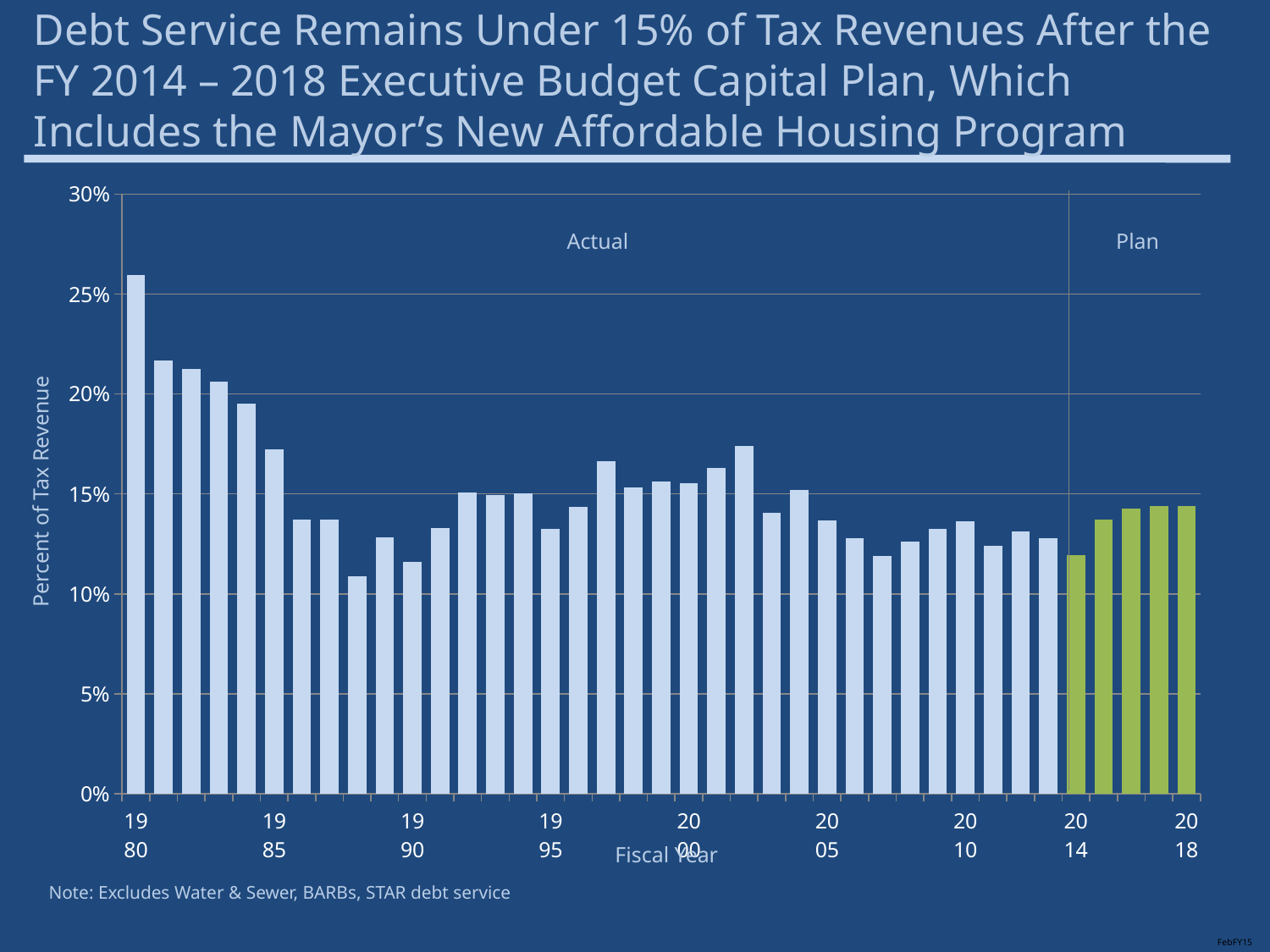
Is the value for fiscal year 2005 greater or less than 15%? less Is the value for fiscal year 1985 greater or less than 15%? greater Is the value for fiscal year 1980 greater or less than 25%? greater What are the two labelled sections of the chart? Actual and Plan What is the title of the vertical axis? Percent of Tax Revenue What kind of chart is shown on the slide? bar chart Which fiscal year has the larger value, 1985 or 1990? 1985 Do the values rise or fall from fiscal year 1980 to fiscal year 1985? fall Which fiscal year has the larger value, 1980 or 2018? 1980 Which fiscal year has the highest debt service as a percent of tax revenue? 1980